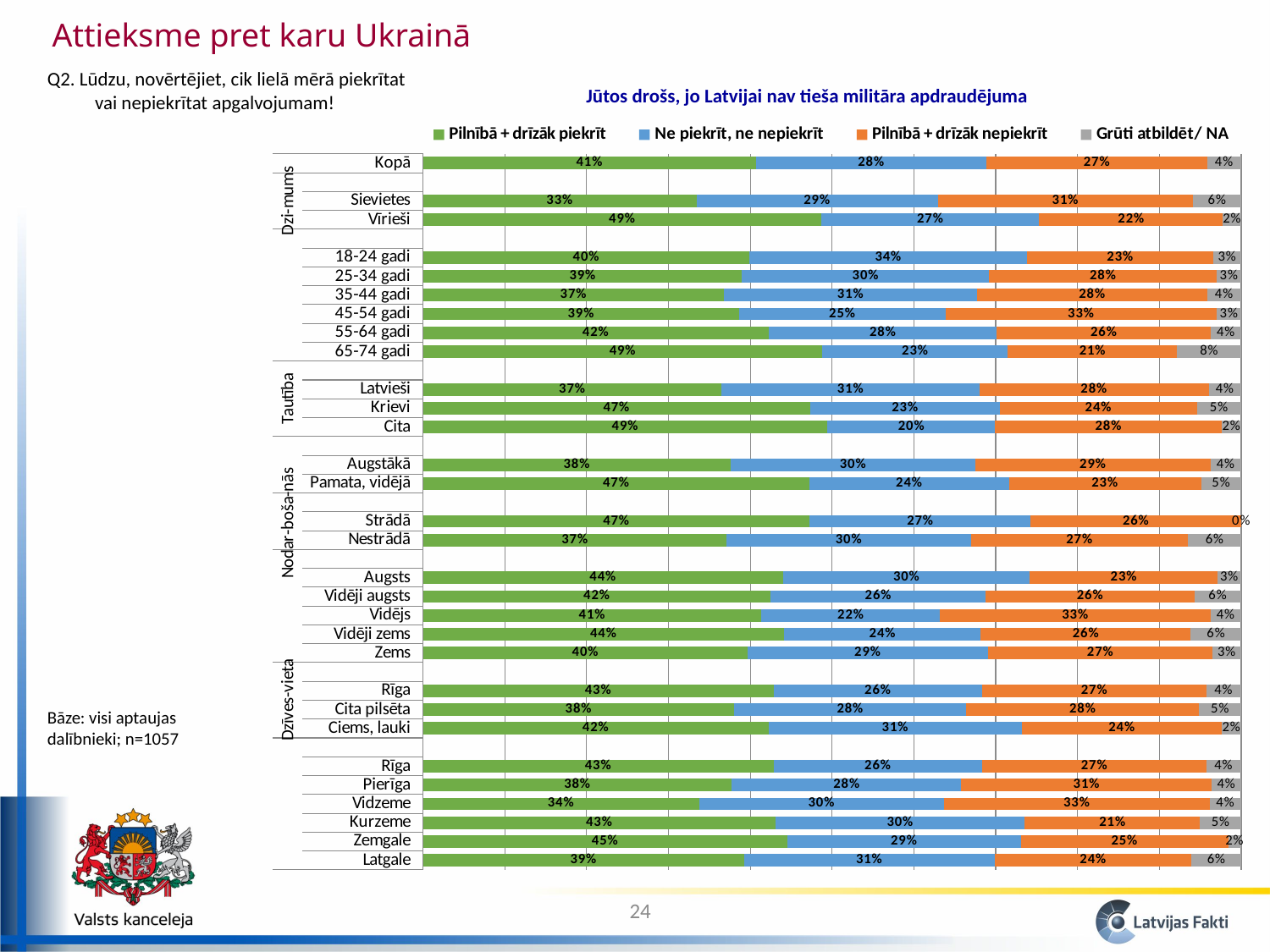
What is the value of "Grūti atbildēt/ NA" for 65-74 gadi? 8% What is the title of the chart? Jūtos drošs, jo Latvijai nav tieša militāra apdraudējuma What kind of chart is shown on the slide? Stacked bar chart What is the total of the four segments in the Kopā bar? 100% Which has a larger value for "Pilnībā + drīzāk piekrīt", Latvieši or Krievi? Krievi What is the value of "Pilnībā + drīzāk piekrīt" for Kopā? 41% What is the value of "Ne piekrīt, ne nepiekrīt" for Latgale? 31% Among the age groups (18-24 gadi to 65-74 gadi), which has the highest value for "Pilnībā + drīzāk piekrīt"? 65-74 gadi What is the difference in "Pilnībā + drīzāk piekrīt" between Vīrieši and Sievietes? 16 percentage points What is the value of "Pilnībā + drīzāk nepiekrīt" for Sievietes? 31% How many series does the legend list? 4 Among the regions Rīga, Pierīga, Vidzeme, Kurzeme, Zemgale and Latgale, which has the lowest value for "Pilnībā + drīzāk piekrīt"? Vidzeme